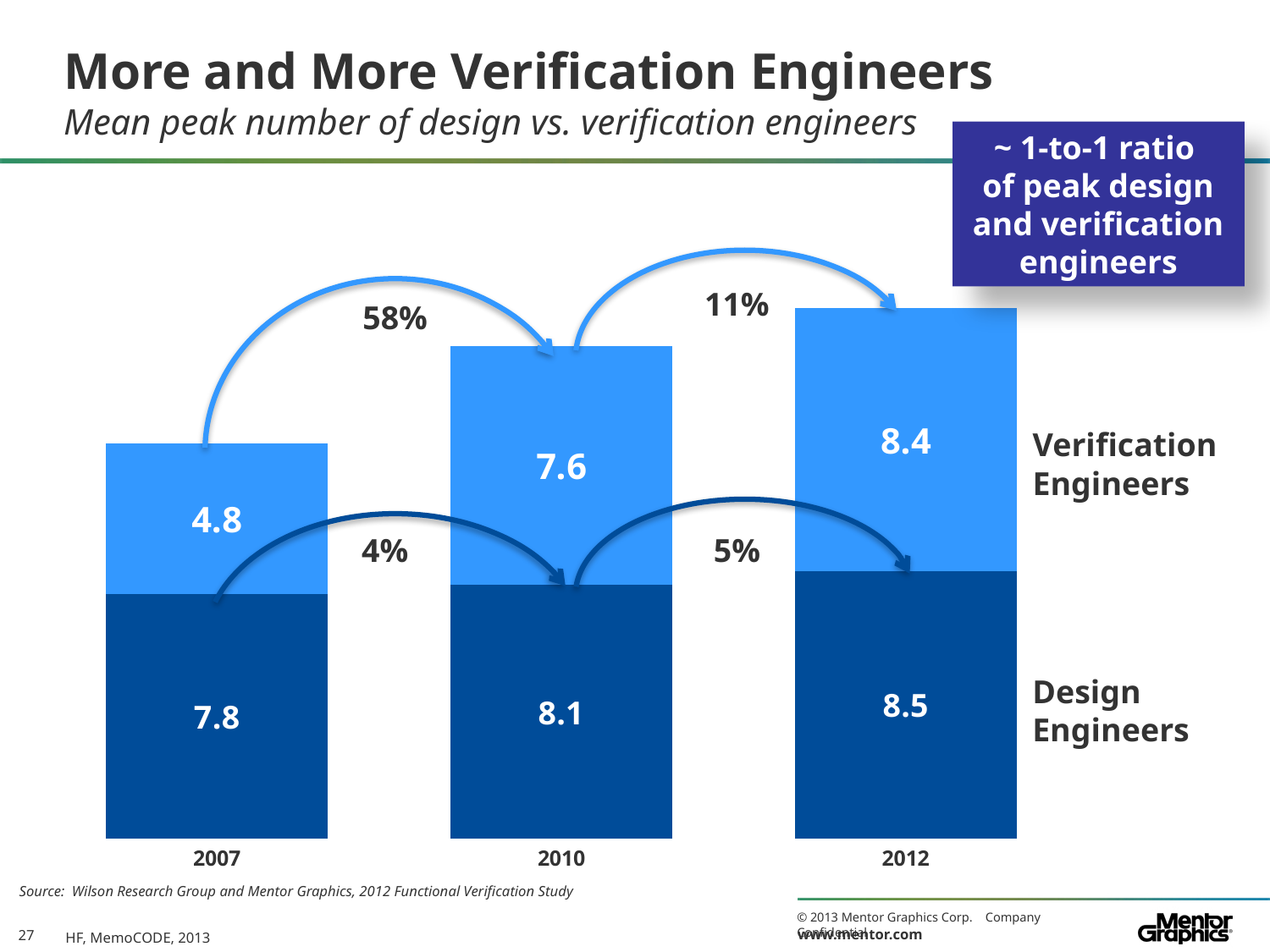
How many years are shown on the x axis? 3 What is the mean peak number of Design Engineers in 2012? 8.5 What kind of chart is shown on the slide? Stacked bar chart Which year has the lowest value for Design Engineers? 2007 Do the Verification Engineers values rise or fall from 2007 to 2012? Rise What is the total of the stacked bar for 2010? 15.7 What is the mean peak number of Verification Engineers in 2007? 4.8 What is the difference between the Design Engineers value and the Verification Engineers value in 2007? 3.0 Which year has the highest value for Verification Engineers? 2012 Which is larger in 2012: the Design Engineers value or the Verification Engineers value? Design Engineers What is the value for Verification Engineers in 2010? 7.6 How many series does the chart show? 2